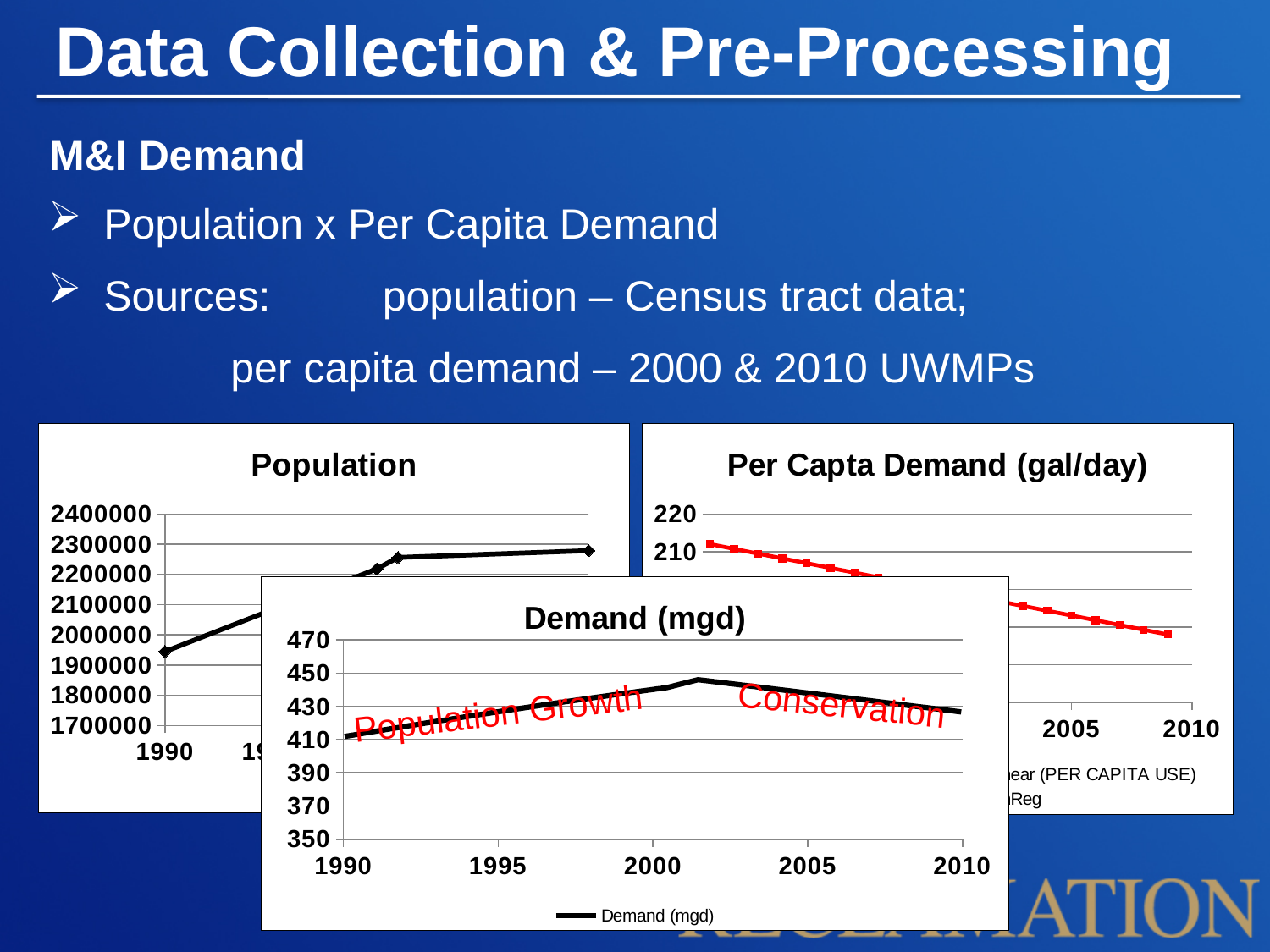
In the Population chart, is the value for 1990 greater or less than 2100000? less In the Demand (mgd) chart, do the values rise or fall between 1990 and 2000? rise In the Demand (mgd) chart, is the peak value around 2001 greater or less than 430? greater What kind of chart is the Population chart? line chart In the Demand (mgd) chart, is the value for 1990 greater or less than 430? less How many series does the legend of the Demand (mgd) chart list? 1 In the Demand (mgd) chart, do the values rise or fall between 2002 and 2010? fall In the Population chart, do the values rise or fall from 1990 onward? rise What two red annotations are written across the Demand (mgd) chart? Population Growth and Conservation What kind of chart is the Demand (mgd) chart? line chart